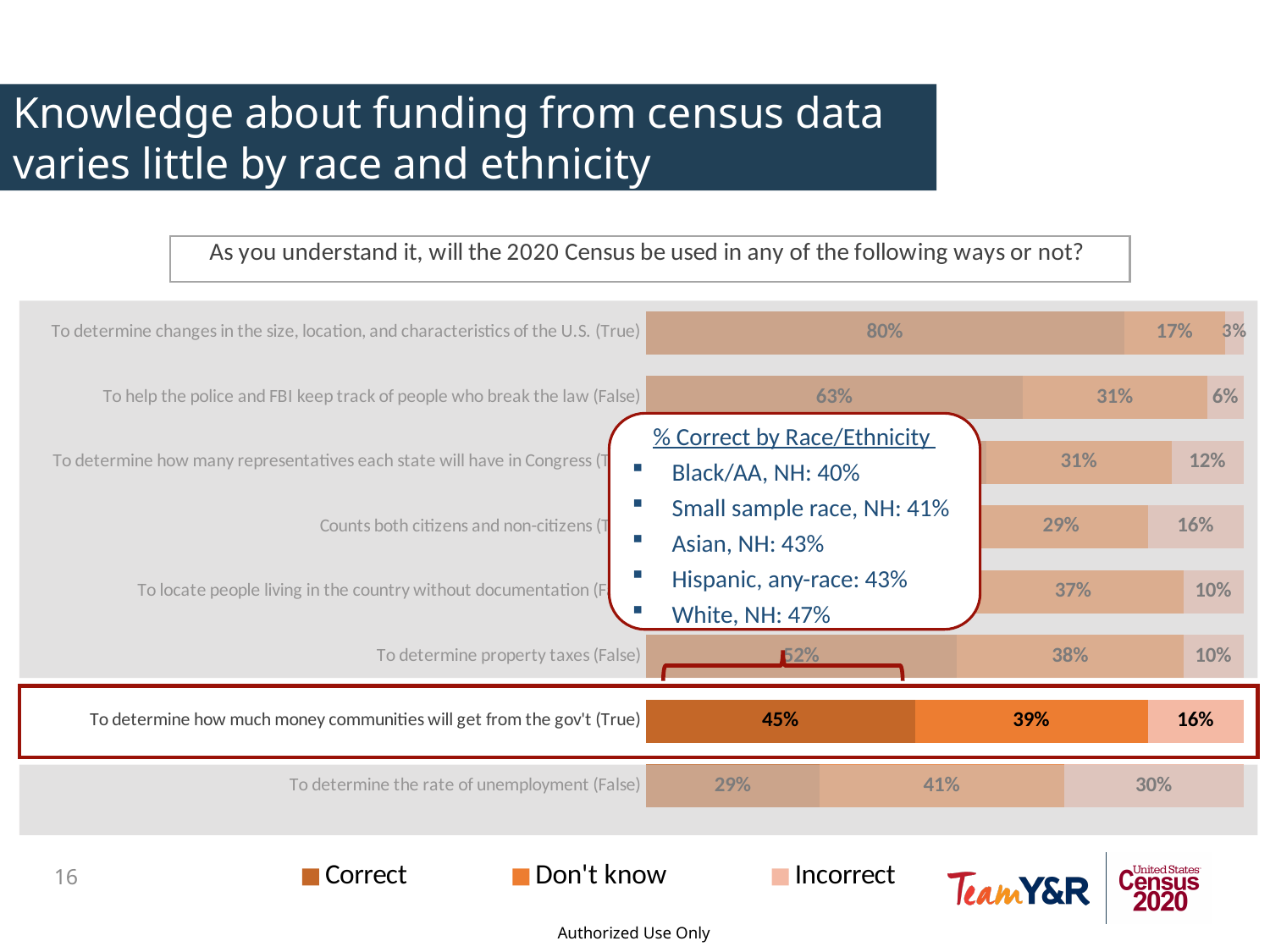
How many series does the legend list? 3 What type of chart is shown on the slide? Stacked bar chart What is the Incorrect percentage for "To help the police and FBI keep track of people who break the law (False)"? 6% How many items (bars) are shown in the chart? 8 Which item has the lowest Correct percentage? To determine the rate of unemployment (False) Which is larger for "To determine how much money communities will get from the gov't (True)": the Correct share or the Don't know share? Correct What is the difference between the Correct percentages for "To determine changes in the size, location, and characteristics of the U.S. (True)" and "To help the police and FBI keep track of people who break the law (False)"? 17% What is the total of the three segments for "To determine the rate of unemployment (False)"? 100% Which legend entry is shown in the lightest colour? Incorrect What is the Don't know percentage for "To determine the rate of unemployment (False)"? 41% Which item has the highest Correct percentage? To determine changes in the size, location, and characteristics of the U.S. (True) What percentage answered Correct for "To determine how much money communities will get from the gov't (True)"? 45%